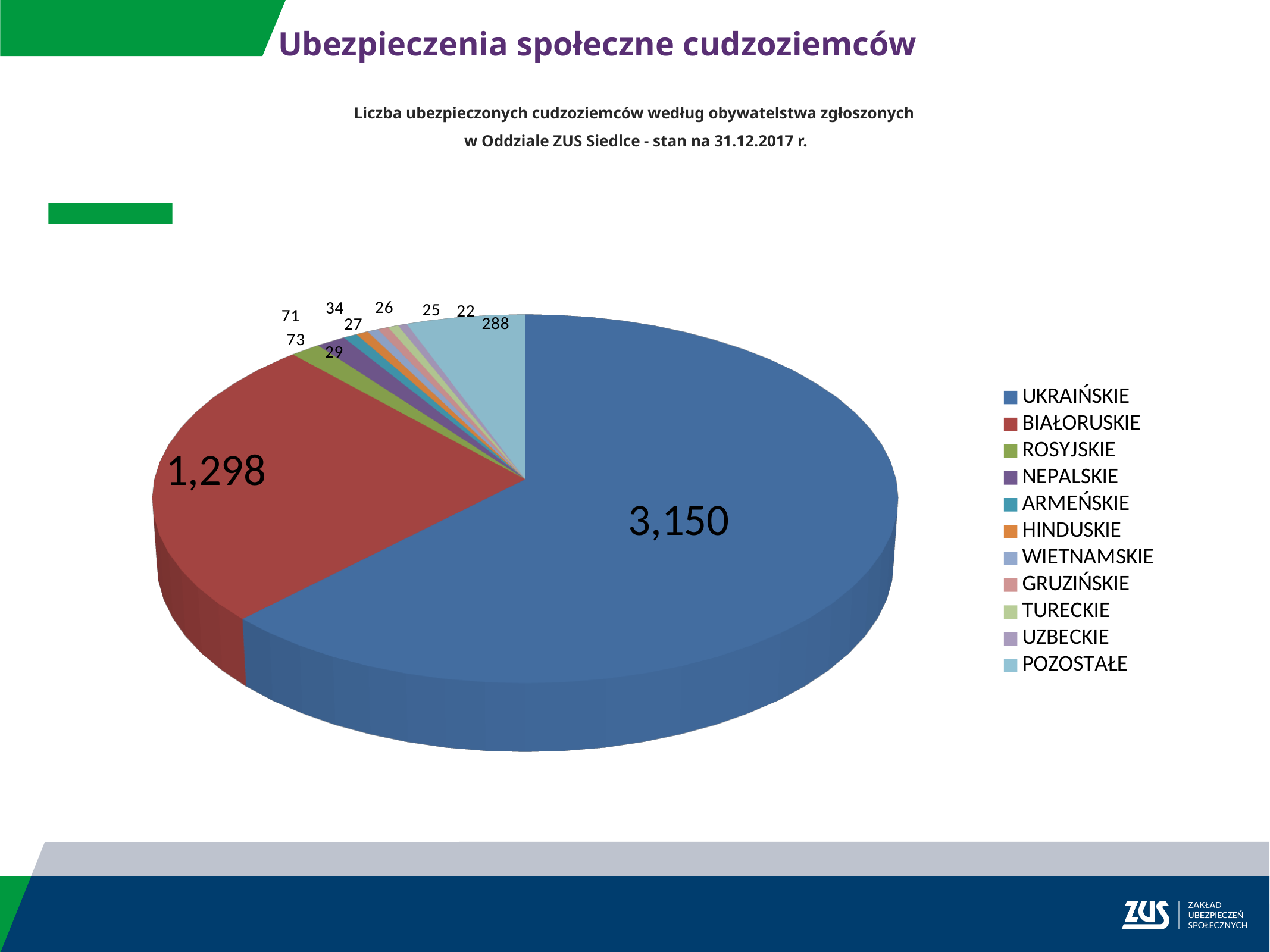
Which citizenship category has the largest slice of the pie? UKRAIŃSKIE What is the smallest value labelled on the pie chart? 22 Which is larger, the value for BIAŁORUSKIE or the value for POZOSTAŁE? BIAŁORUSKIE What is the date given in the chart title for the data? 31.12.2017 r. What is the value for POZOSTAŁE? 288 Which ZUS branch does the chart title refer to? Oddział ZUS Siedlce What is the difference between the values for BIAŁORUSKIE and POZOSTAŁE? 1,010 What is the value for BIAŁORUSKIE? 1,298 What kind of chart is shown on the slide? pie chart What is the difference between the values for UKRAIŃSKIE and BIAŁORUSKIE? 1,852 What is the value for UKRAIŃSKIE? 3,150 How many citizenship categories does the legend list? 11